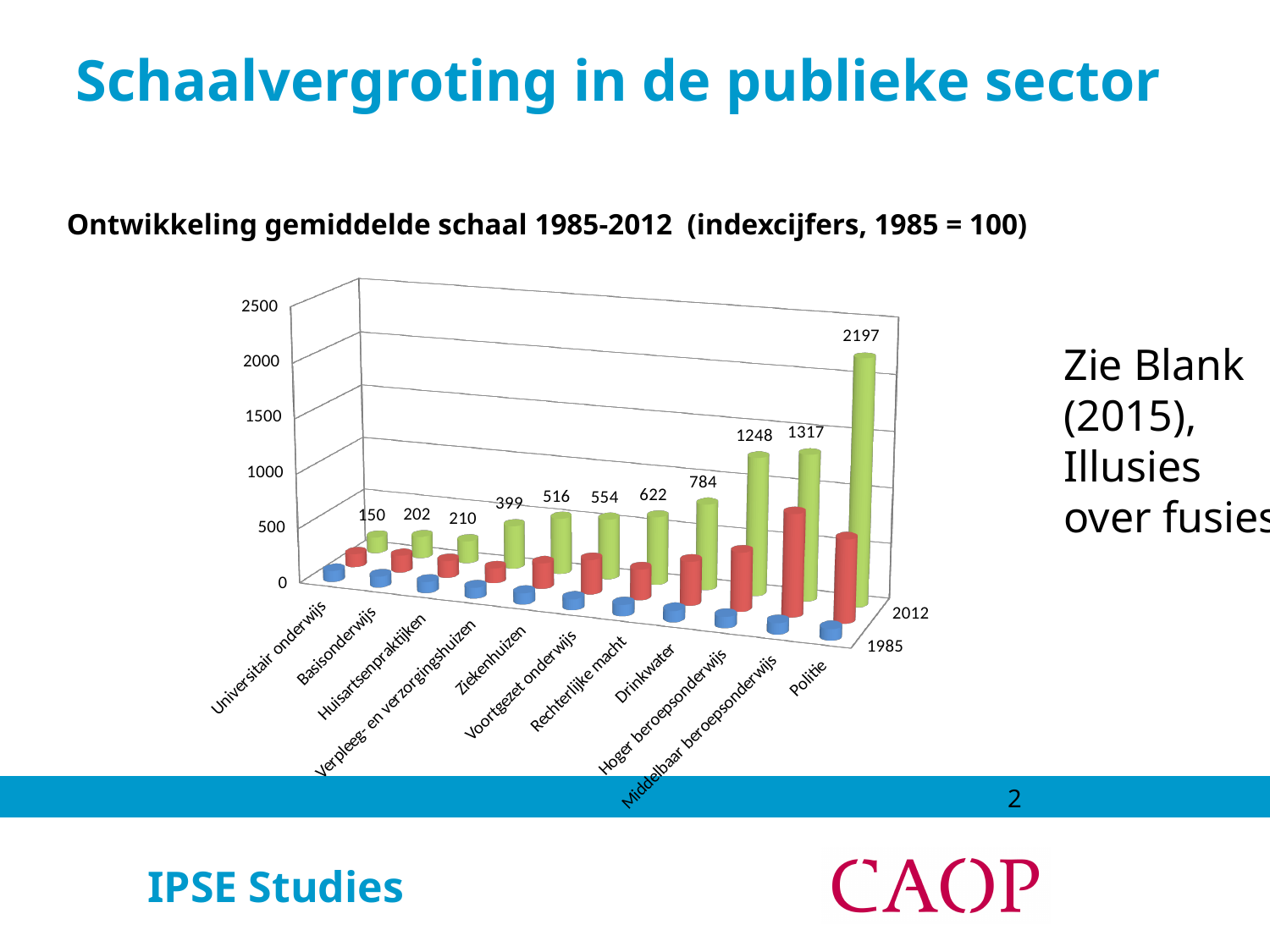
What is the 2012 index value for Universitair onderwijs? 150 Is the 2012 index value for Voortgezet onderwijs greater or less than 500? greater How many sectors are shown on the category axis? 11 What kind of chart is shown on the slide? Bar chart Do the 2012 index values rise or fall moving from Universitair onderwijs to Politie along the category axis? Rise What is the difference between the 2012 index values for Middelbaar beroepsonderwijs and Hoger beroepsonderwijs? 69 What is the 2012 index value for Drinkwater? 784 What is the 2012 index value for Politie? 2197 Which has a larger 2012 index value, Rechterlijke macht or Basisonderwijs? Rechterlijke macht Which sector has the highest 2012 index value? Politie Which sector has the lowest 2012 index value? Universitair onderwijs What is the 2012 index value for Ziekenhuizen? 516